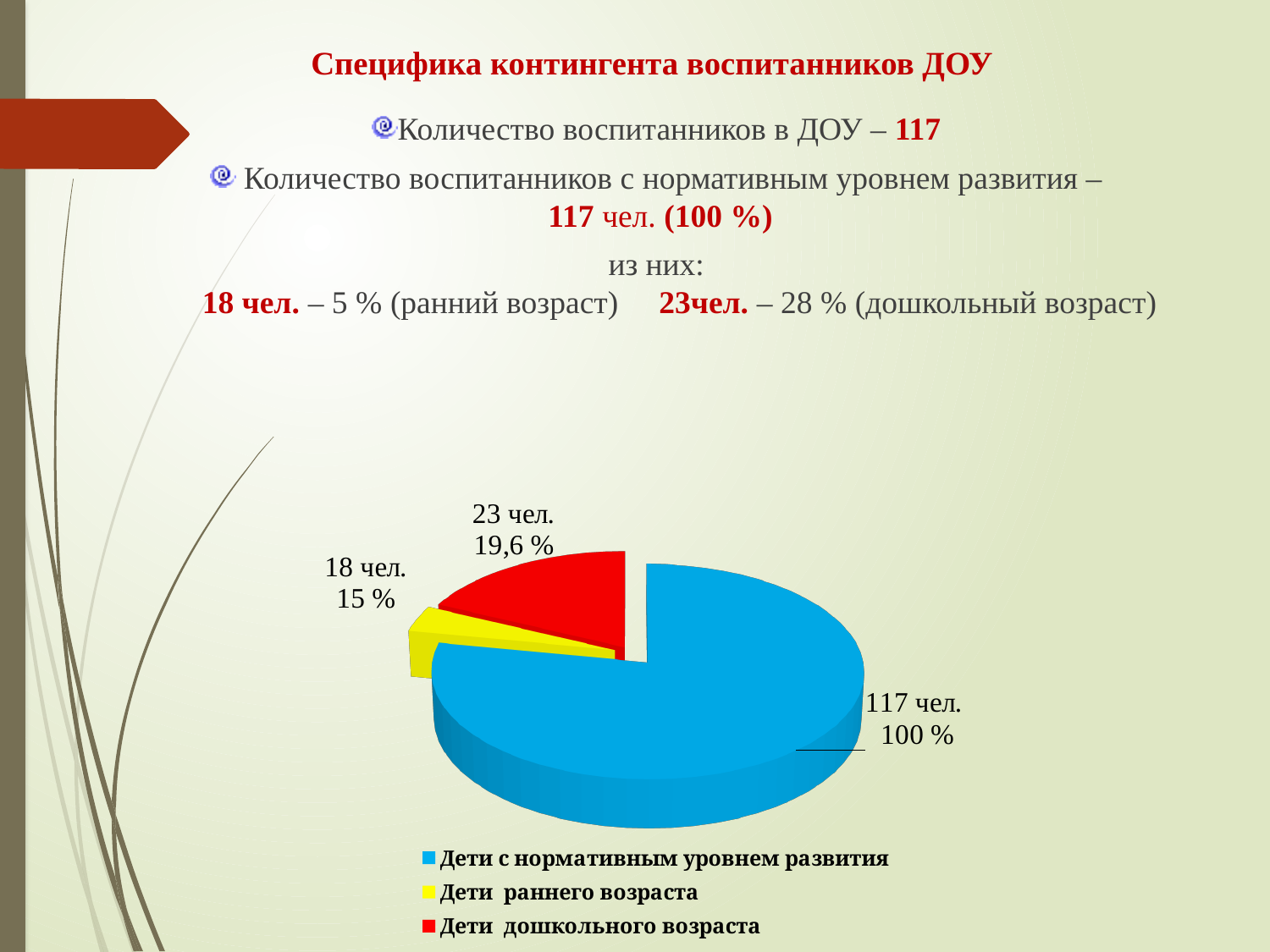
What kind of chart is shown on the slide? pie chart What number of children is labelled on the slice for 'Дети дошкольного возраста'? 23 чел. Which slice is larger: 'Дети раннего возраста' or 'Дети дошкольного возраста'? Дети дошкольного возраста Which slice of the pie chart is the smallest? Дети раннего возраста What number of children is labelled on the slice for 'Дети с нормативным уровнем развития'? 117 чел. What percentage is printed on the slice for 'Дети раннего возраста'? 15 % What number of children is labelled on the slice for 'Дети раннего возраста'? 18 чел. How many entries does the legend of the pie chart list? 3 Which slice of the pie chart is the largest? Дети с нормативным уровнем развития How many slices does the pie chart have? 3 What percentage is printed on the slice for 'Дети дошкольного возраста'? 19,6 % What colour is the slice for 'Дети дошкольного возраста'? red